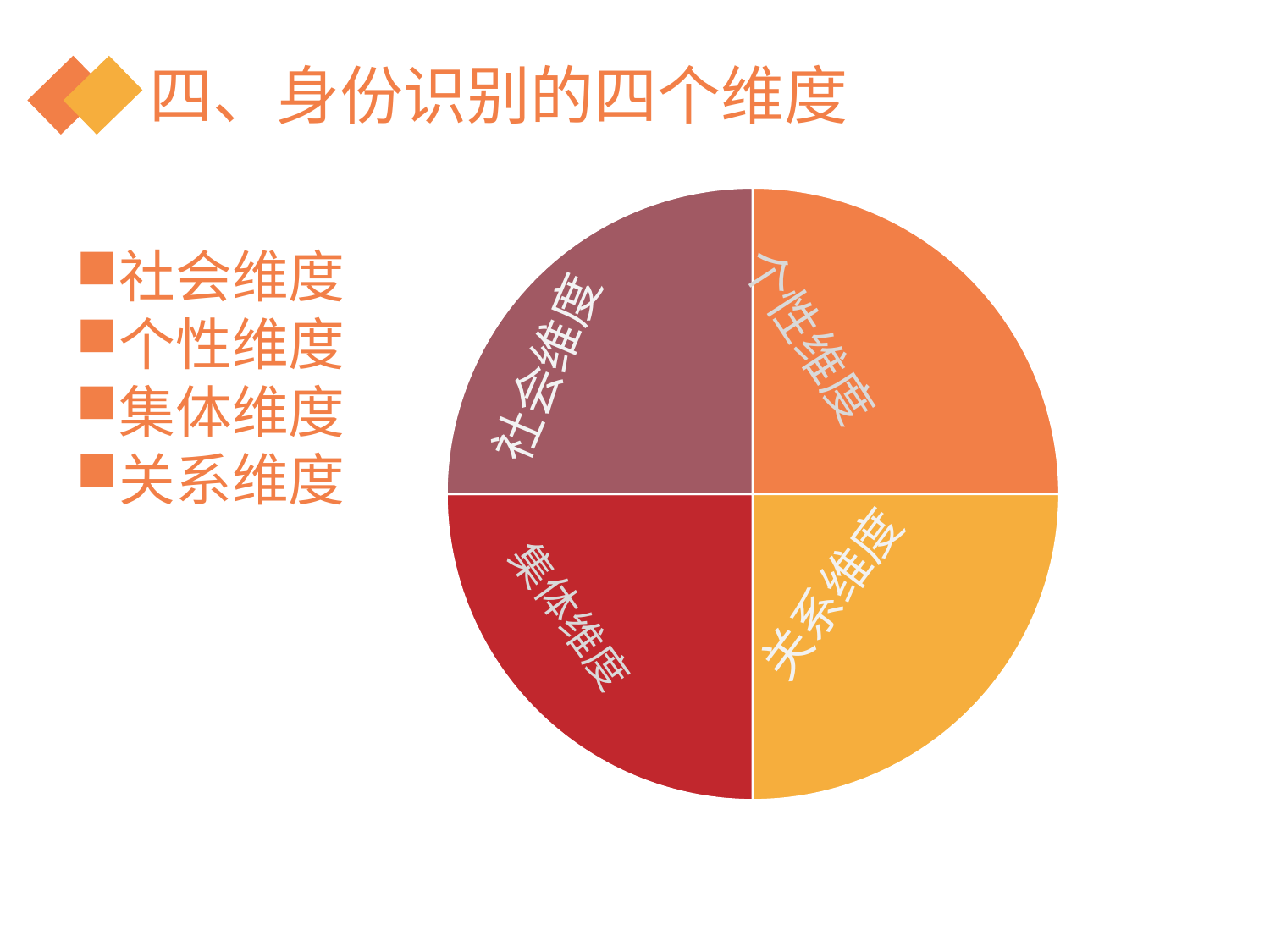
What is the title of the slide containing the pie chart? 四、身份识别的四个维度 What kind of chart is shown on the slide? pie chart Which slice of the pie chart is in the top-right quarter? 个性维度 How many slices does the pie chart have? 4 Which slice of the pie chart is coloured dark red? 集体维度 Are the four slices of the pie chart equal in size? yes